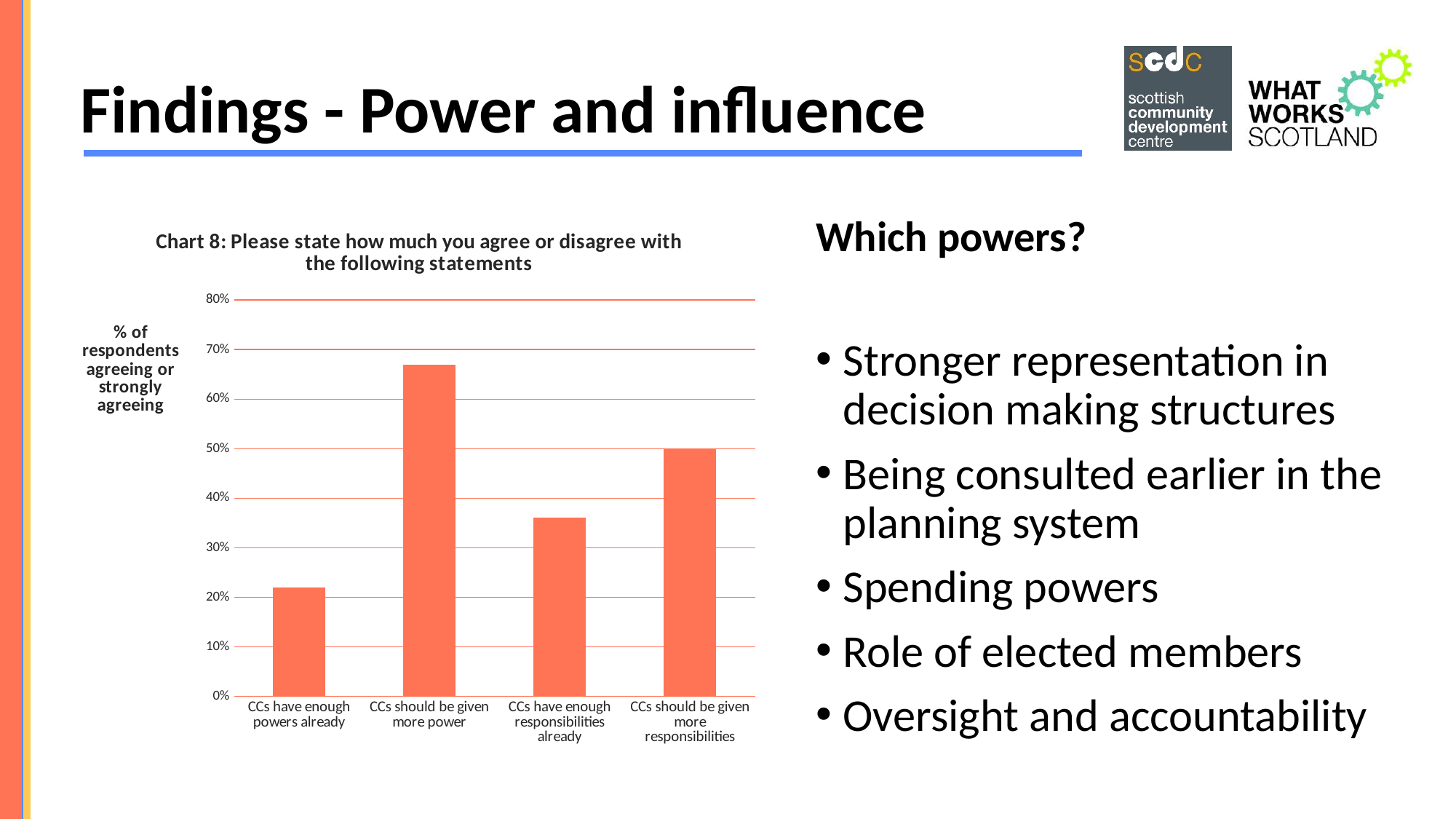
Which statement has the highest percentage of respondents agreeing or strongly agreeing? CCs should be given more power Which statement has the lowest percentage of respondents agreeing or strongly agreeing? CCs have enough powers already What is the title of the chart on the slide? Chart 8: Please state how much you agree or disagree with the following statements Which is larger: the value for 'CCs should be given more power' or the value for 'CCs should be given more responsibilities'? CCs should be given more power Is the value for 'CCs have enough powers already' greater or less than 30%? less What kind of chart is shown on the slide? Bar chart How many statements (categories) are plotted in Chart 8? 4 Is the value for 'CCs should be given more power' greater or less than 60%? greater What does the vertical axis of the chart measure? % of respondents agreeing or strongly agreeing Is the value for 'CCs have enough responsibilities already' greater or less than 30%? greater What percentage of respondents agree or strongly agree that CCs should be given more responsibilities? 50%